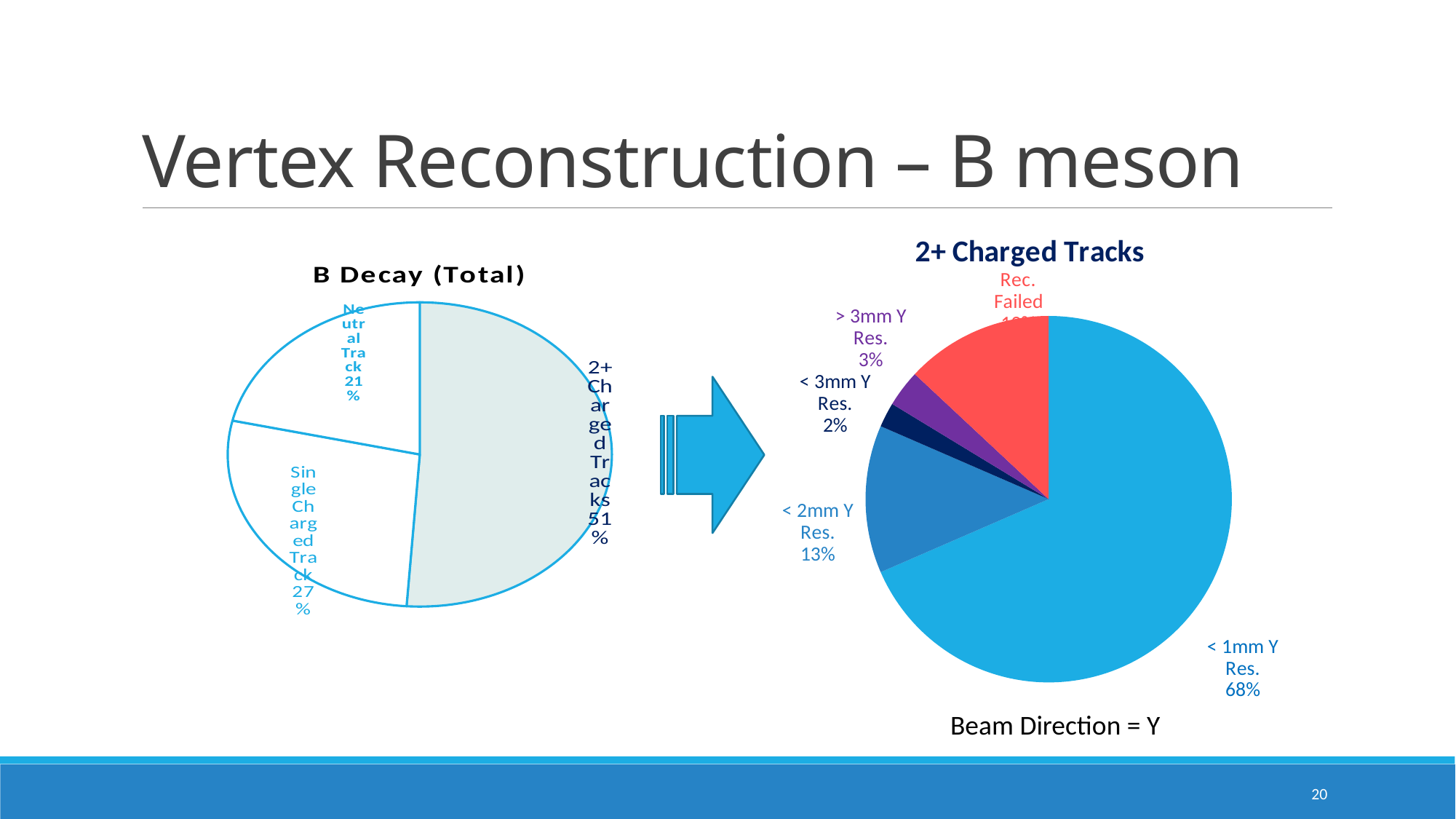
In the '2+ Charged Tracks' chart, what share of the pie is '< 1mm Y Res.'? 68% In the 'B Decay (Total)' chart, how many slices does the pie have? 3 What type of chart is the chart on the right of the slide? Pie chart In the 'B Decay (Total)' chart, which category has the smallest slice? Neutral Track In the 'B Decay (Total)' chart, what percentage is labelled for 'Single Charged Track'? 27% In the '2+ Charged Tracks' chart, which is larger, '< 3mm Y Res.' or '> 3mm Y Res.'? > 3mm Y Res. In the 'B Decay (Total)' chart, what percentage is labelled for 'Neutral Track'? 21% In the 'B Decay (Total)' chart, what share of the pie is '2+ Charged Tracks'? 51% In the '2+ Charged Tracks' chart, what percentage is labelled for '< 2mm Y Res.'? 13% In the '2+ Charged Tracks' chart, which category has the largest slice? < 1mm Y Res. In the 'B Decay (Total)' chart, which category has the largest slice? 2+ Charged Tracks In the '2+ Charged Tracks' chart, what is the difference between '< 1mm Y Res.' and '< 2mm Y Res.'? 55%